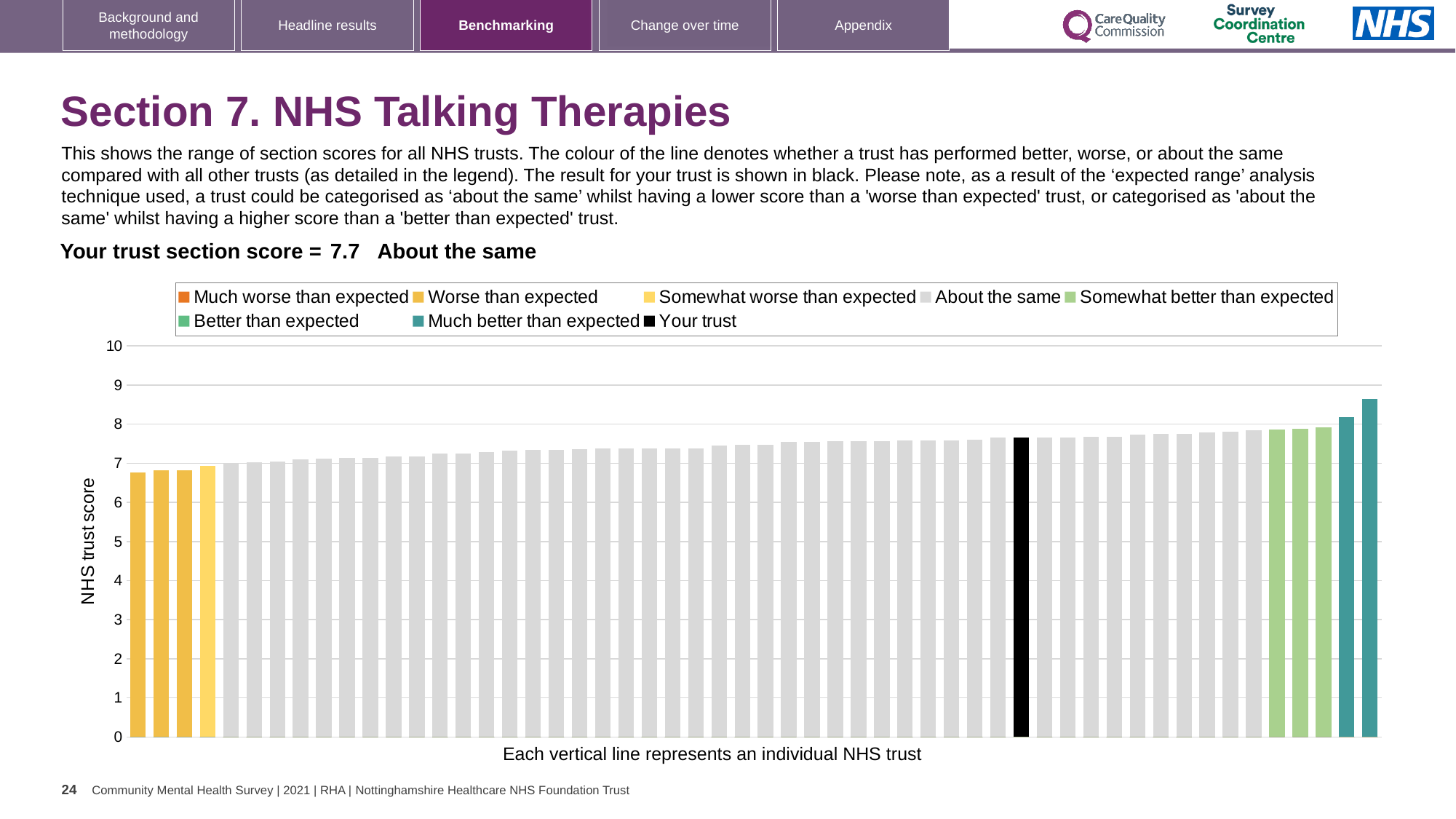
How many entries does the chart legend list? 8 Is the value of the black 'Your trust' bar greater or less than 8? less Is the value of the shortest bar in the chart greater or less than 7? less What colour is the bar representing your trust? black What is the label on the vertical axis of the chart? NHS trust score Is the value of the tallest bar in the chart greater or less than 8? greater Do the bar values rise or fall from left to right along the x axis? rise Which legend category do the tallest bars in the chart belong to? Much better than expected Which legend category do the shortest bars in the chart belong to? Worse than expected What is the section score for your trust shown on the slide? 7.7 What kind of chart is shown on the slide? bar chart